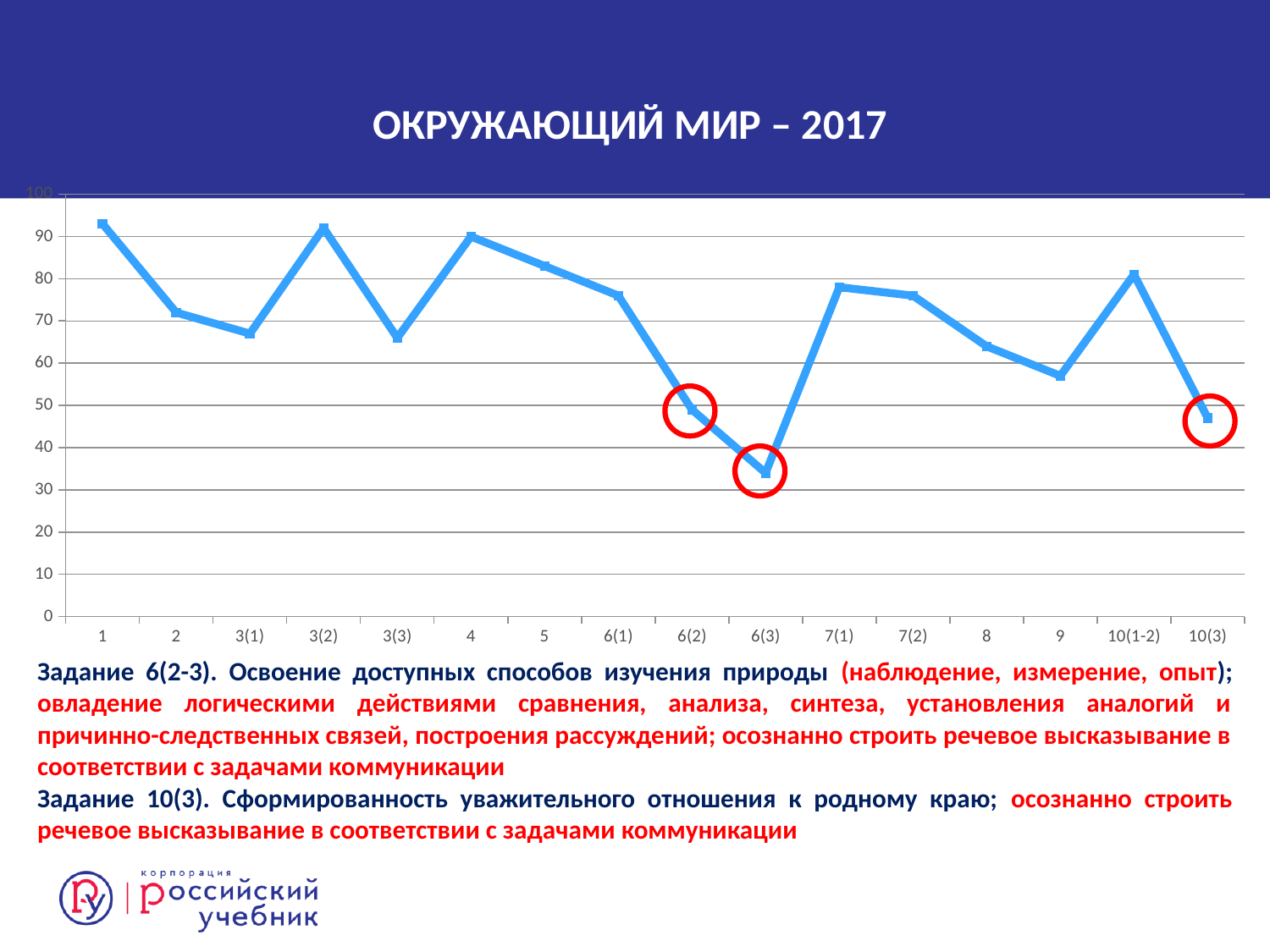
Is the value for 9 greater or less than 60? less What kind of chart is shown on the slide? line chart What is the title of the chart? ОКРУЖАЮЩИЙ МИР – 2017 Which has the larger value, 6(3) or 7(1)? 7(1) Is the value for 7(1) greater or less than 70? greater Is the value for 1 greater or less than 90? greater Which has the larger value, 4 or 3(3)? 4 Do the values rise or fall from 6(1) to 6(3)? fall How many categories are shown on the x axis of the chart? 16 Which category has the lowest value on the chart? 6(3)